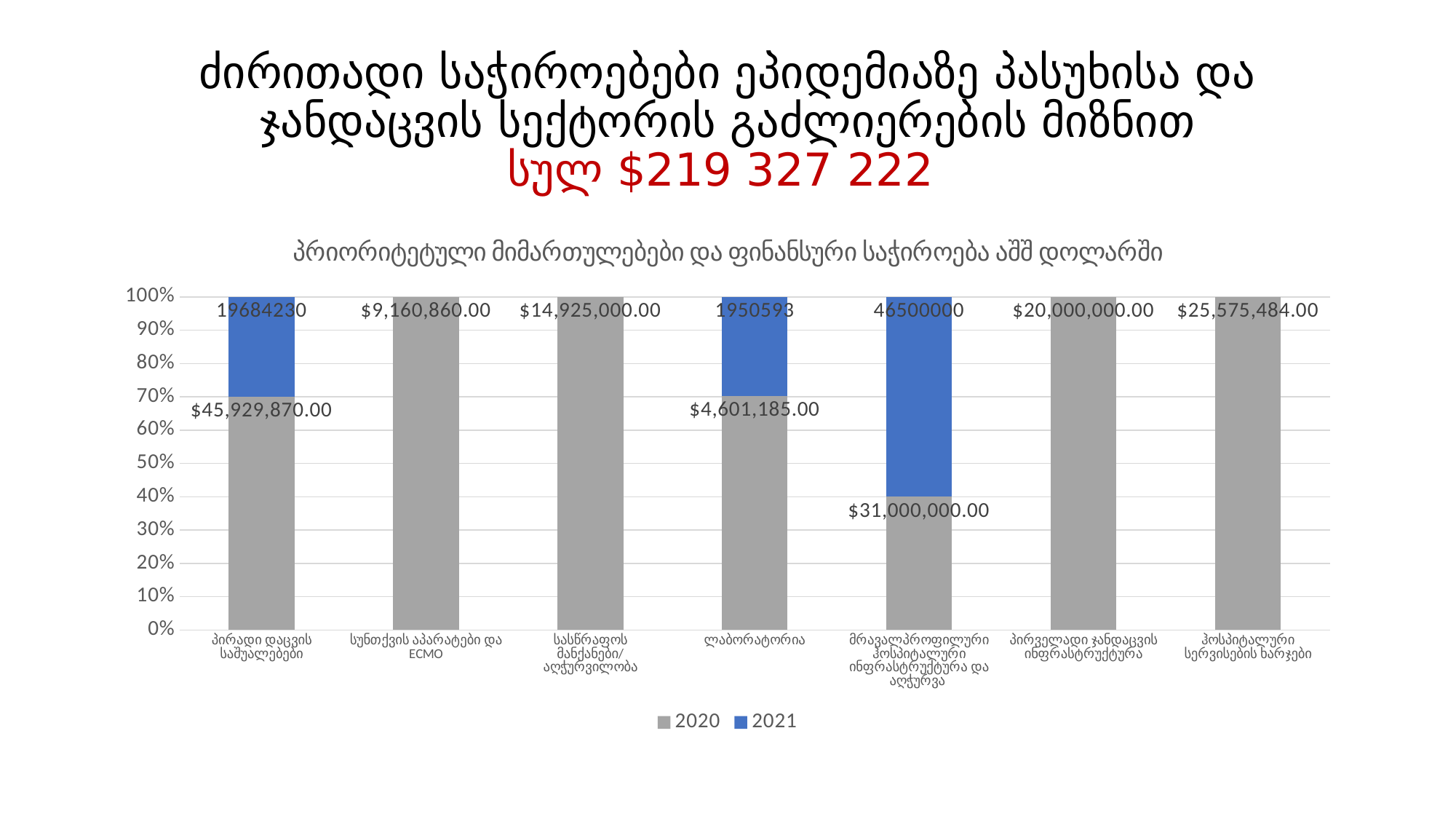
What is the 2021 value for მრავალპროფილური ჰოსპიტალური ინფრასტრუქტურა და აღჭურვა? 46500000 What is the 2020 value for სუნთქვის აპარატები და ECMO? $9,160,860.00 What is the 2020 value for ლაბორატორია? $4,601,185.00 How many series does the chart legend list? 2 What is the 2020 value for პირადი დაცვის საშუალებები? $45,929,870.00 What kind of chart is shown on the slide? Stacked bar chart Which category has the highest 2020 value? პირადი დაცვის საშუალებები How many categories are shown along the x axis of the chart? 7 What is the 2021 value for პირადი დაცვის საშუალებები? 19684230 Is the 2021 share of the bar for მრავალპროფილური ჰოსპიტალური ინფრასტრუქტურა და აღჭურვა greater or less than 50%? greater What are the two series named in the chart legend? 2020 and 2021 Which category has the lowest 2020 value? ლაბორატორია